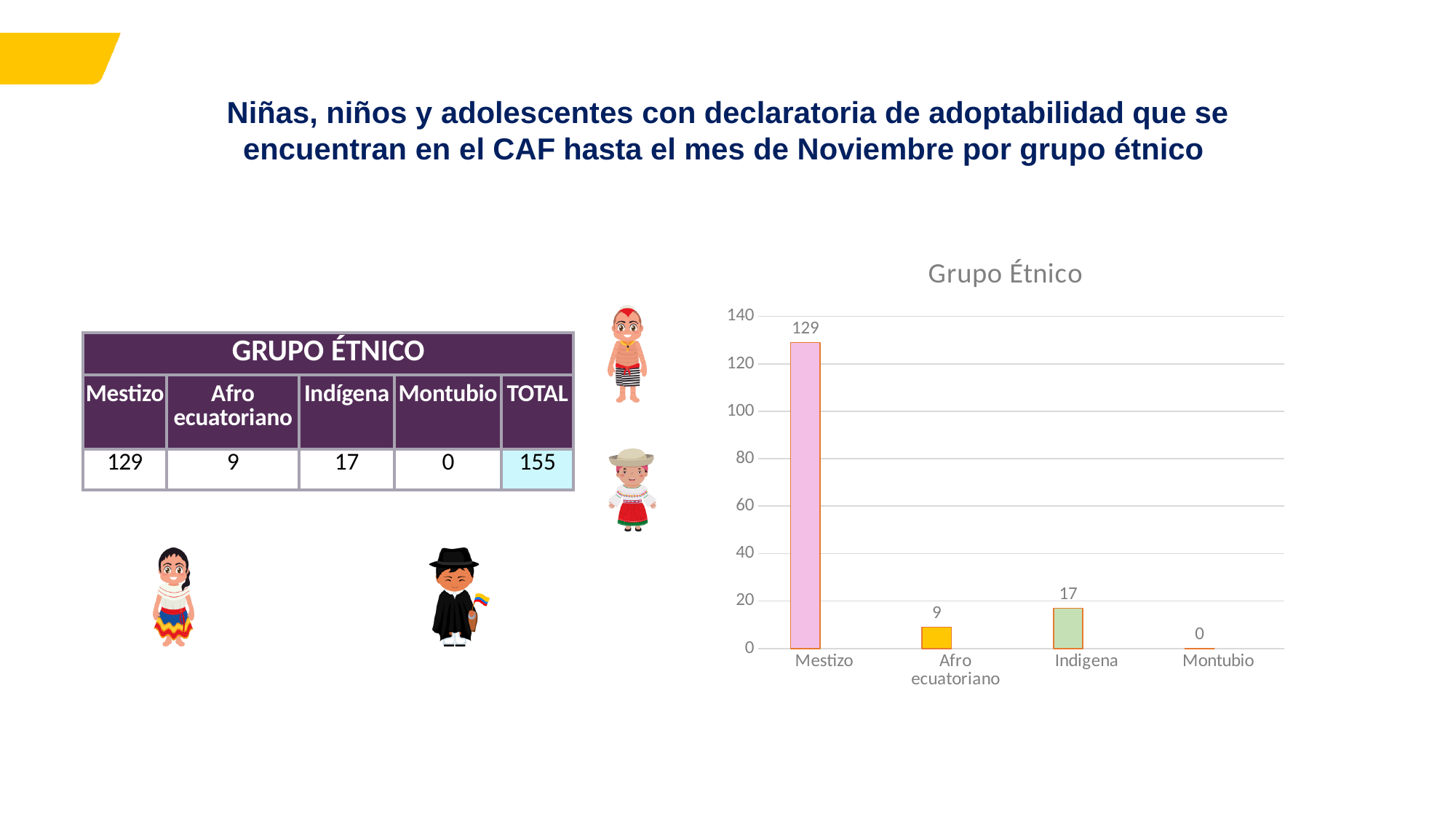
How many categories are shown in the Grupo Étnico chart? 4 What kind of chart is the Grupo Étnico chart? Bar chart Which is larger in the Grupo Étnico chart, Afro ecuatoriano or Indigena? Indigena What is the difference between the values for Mestizo and Indigena in the Grupo Étnico chart? 112 What is the value for Indigena in the Grupo Étnico chart? 17 What is the difference between the values for Indigena and Afro ecuatoriano in the Grupo Étnico chart? 8 What is the value for Afro ecuatoriano in the Grupo Étnico chart? 9 Which category has the highest value in the Grupo Étnico chart? Mestizo What is the value for Mestizo in the Grupo Étnico chart? 129 Is the value for Mestizo in the Grupo Étnico chart greater or less than 120? greater What is the value for Montubio in the Grupo Étnico chart? 0 Which category has the lowest value in the Grupo Étnico chart? Montubio